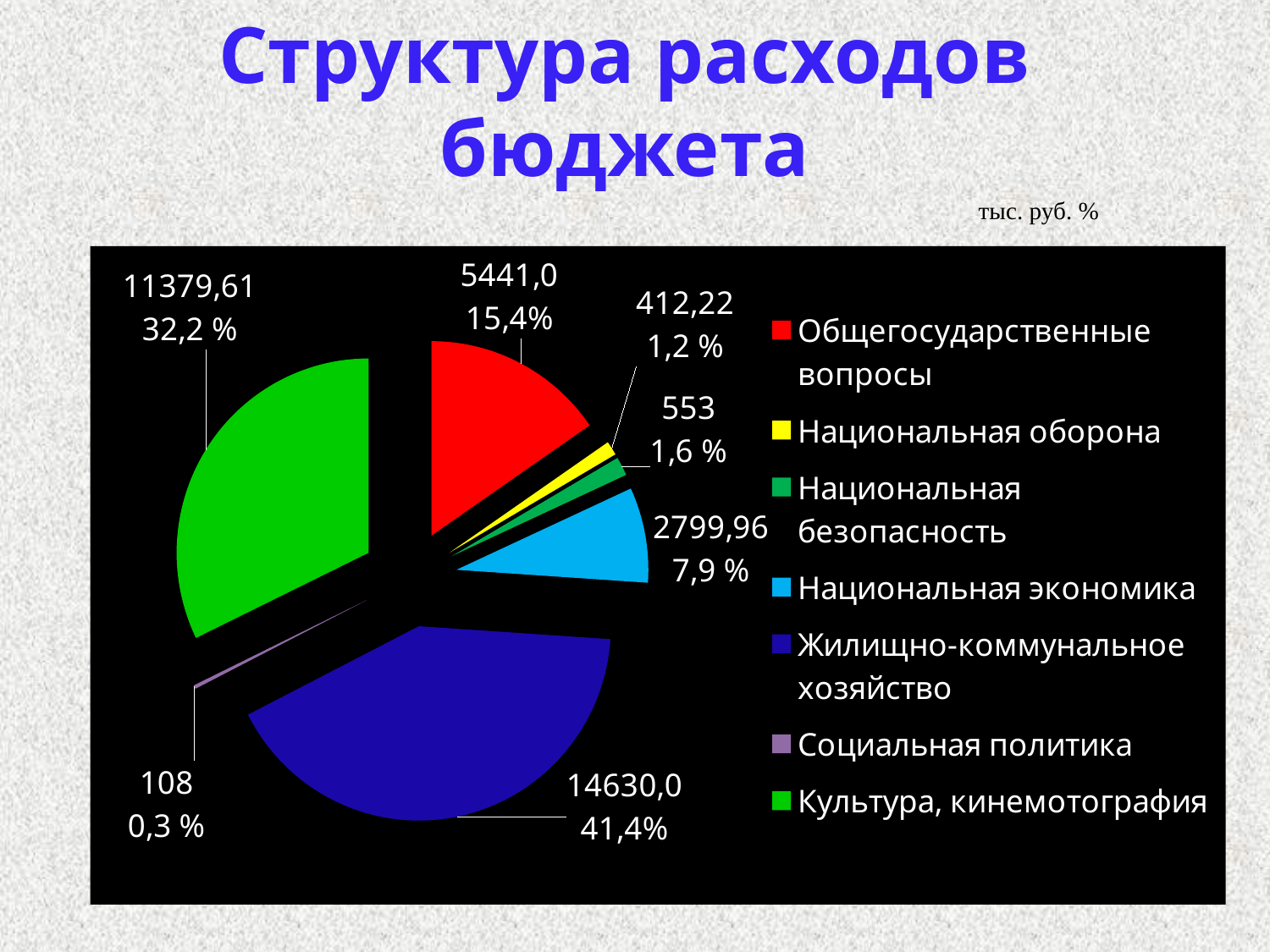
How many categories does the legend of the pie chart list? 7 What colour is the slice for Национальная экономика? light blue What value (тыс. руб.) is shown for Жилищно-коммунальное хозяйство? 14630,0 What kind of chart is shown on the slide? pie chart What percentage share is shown for Социальная политика? 0,3 % What percentage share is shown for Национальная экономика? 7,9 % Which category has the largest slice of the pie? Жилищно-коммунальное хозяйство What value (тыс. руб.) is shown for Общегосударственные вопросы? 5441,0 Which is larger: the value for Национальная оборона or the value for Национальная безопасность? Национальная безопасность What percentage share is shown for Культура, кинемотография? 32,2 % Which category has the smallest slice of the pie? Социальная политика What is the difference between the values for Жилищно-коммунальное хозяйство (14630,0) and Культура, кинемотография (11379,61)? 3250,39